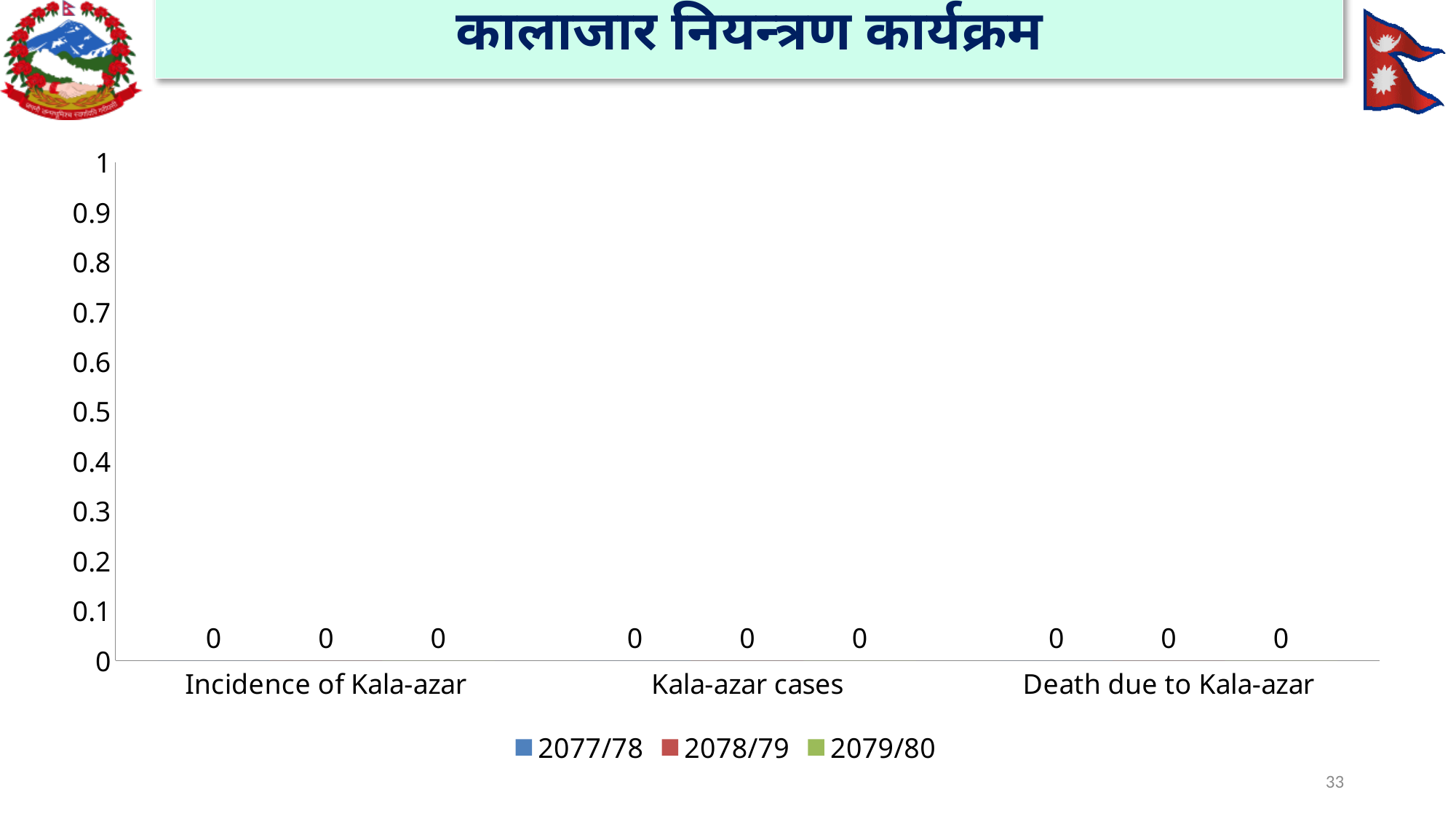
What is the value for 2078/79 in the Kala-azar cases category? 0 What is the value for 2077/78 in the Incidence of Kala-azar category? 0 What is the value for 2079/80 in the Kala-azar cases category? 0 How many categories are shown on the x axis of the chart? 3 What is the label of the middle category on the x axis? Kala-azar cases How many series does the legend list? 3 What is the value for 2079/80 in the Death due to Kala-azar category? 0 Is the value for 2078/79 in the Incidence of Kala-azar category greater or less than 0.5? less What is the difference between the 2078/79 and 2077/78 values for Kala-azar cases? 0 Which series is shown in green in the legend? 2079/80 What is the highest value shown on the y axis of the chart? 1 What is the value for 2077/78 in the Death due to Kala-azar category? 0